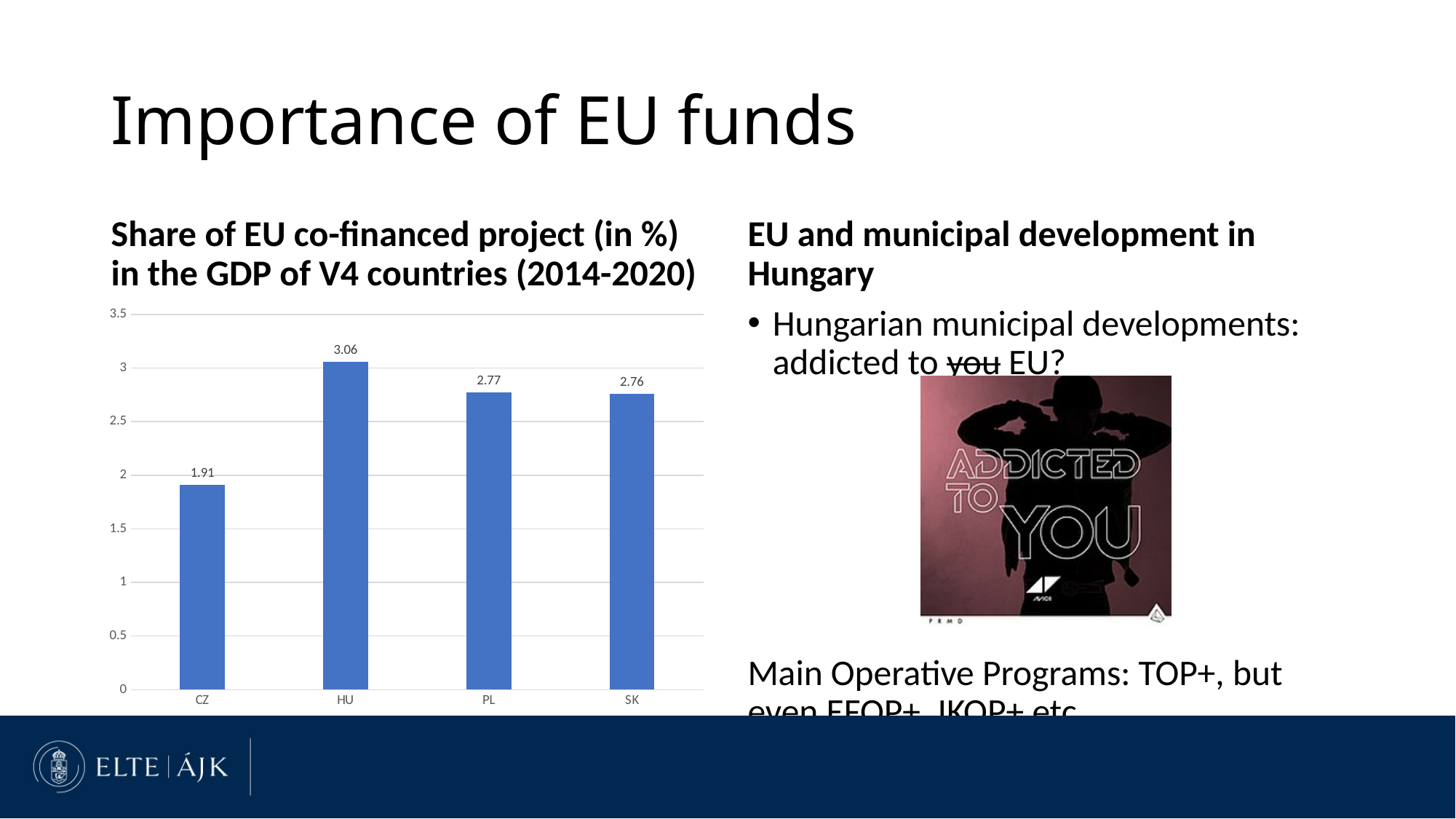
Is the value for CZ greater or less than 2? less Which country has the lowest share of EU co-financed projects in GDP? CZ How many countries are shown in the chart? 4 What is the value for HU in the chart? 3.06 Which is larger, the value for HU or the value for PL? HU What is the value for SK in the chart? 2.76 What is the difference between the values for HU and CZ? 1.15 Which country has the highest share of EU co-financed projects in GDP? HU What is the value for CZ in the chart? 1.91 What is the difference between the values for PL and SK? 0.01 What is the value for PL in the chart? 2.77 What kind of chart is shown on the slide? Bar chart